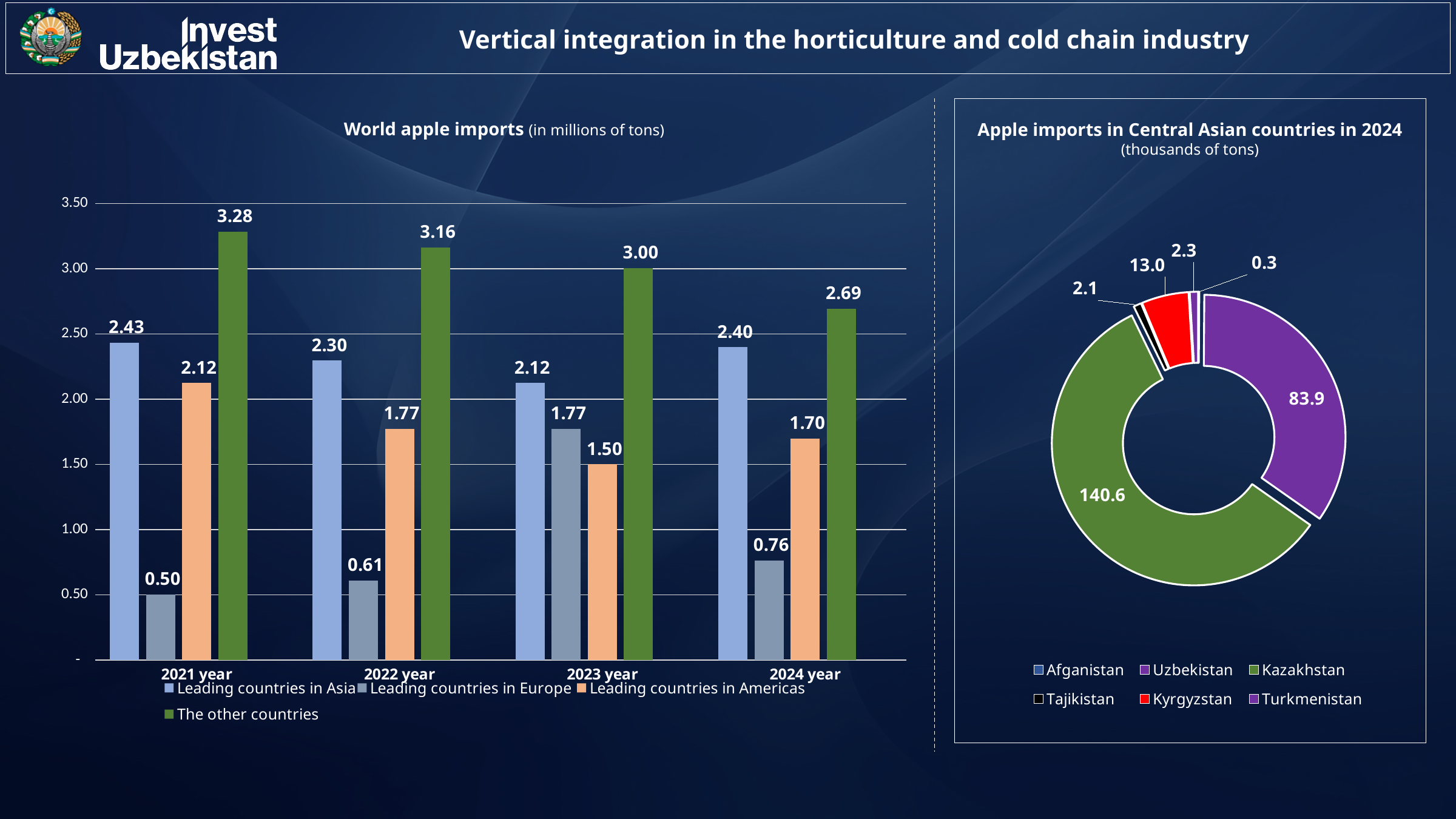
In the World apple imports chart, in which year is the value for Leading countries in Europe lowest? 2021 year In the Apple imports in Central Asian countries in 2024 chart, which country has the largest slice? Kazakhstan In the World apple imports chart, which is larger in 2022 year: Leading countries in Asia or Leading countries in Americas? Leading countries in Asia In the Apple imports in Central Asian countries in 2024 chart, what is the difference between Kazakhstan and Uzbekistan? 56.7 In the World apple imports chart, in which year is the value for The other countries highest? 2021 year In the Apple imports in Central Asian countries in 2024 chart, what is the value for Kazakhstan? 140.6 In the World apple imports chart, what is the value for Leading countries in Europe in 2023 year? 1.77 In the World apple imports chart, what is the value for The other countries in 2021 year? 3.28 What kind of chart is the World apple imports chart? bar chart In the World apple imports chart, what is the difference between Leading countries in Asia in 2021 year and in 2024 year? 0.03 In the World apple imports chart, do the values for The other countries rise or fall from 2021 year to 2024 year? fall How many series does the legend of the World apple imports chart list? 4